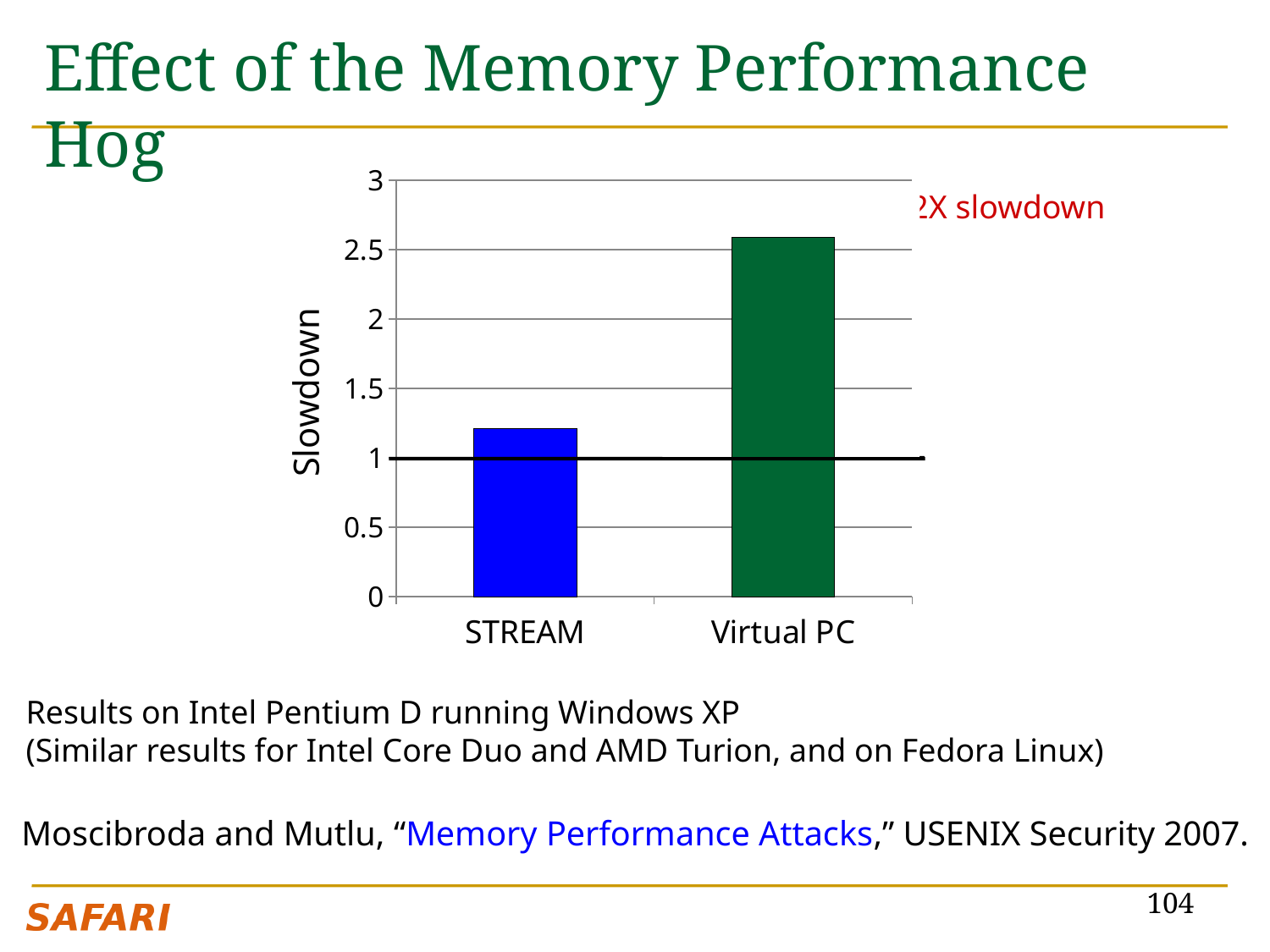
What kind of chart is shown on the slide? bar chart Do the values rise or fall going from STREAM to Virtual PC along the x axis? rise Is the slowdown for STREAM greater or less than 1.5? less Which category has the highest slowdown in the chart? Virtual PC Is the slowdown for Virtual PC greater or less than 2.5? greater Which has a larger slowdown, STREAM or Virtual PC? Virtual PC Is the slowdown for STREAM greater or less than 1? greater How many categories are plotted on the x axis of the chart? 2 Which category has the lowest slowdown in the chart? STREAM What is the label on the y axis of the chart? Slowdown What colour is the bar for Virtual PC? green